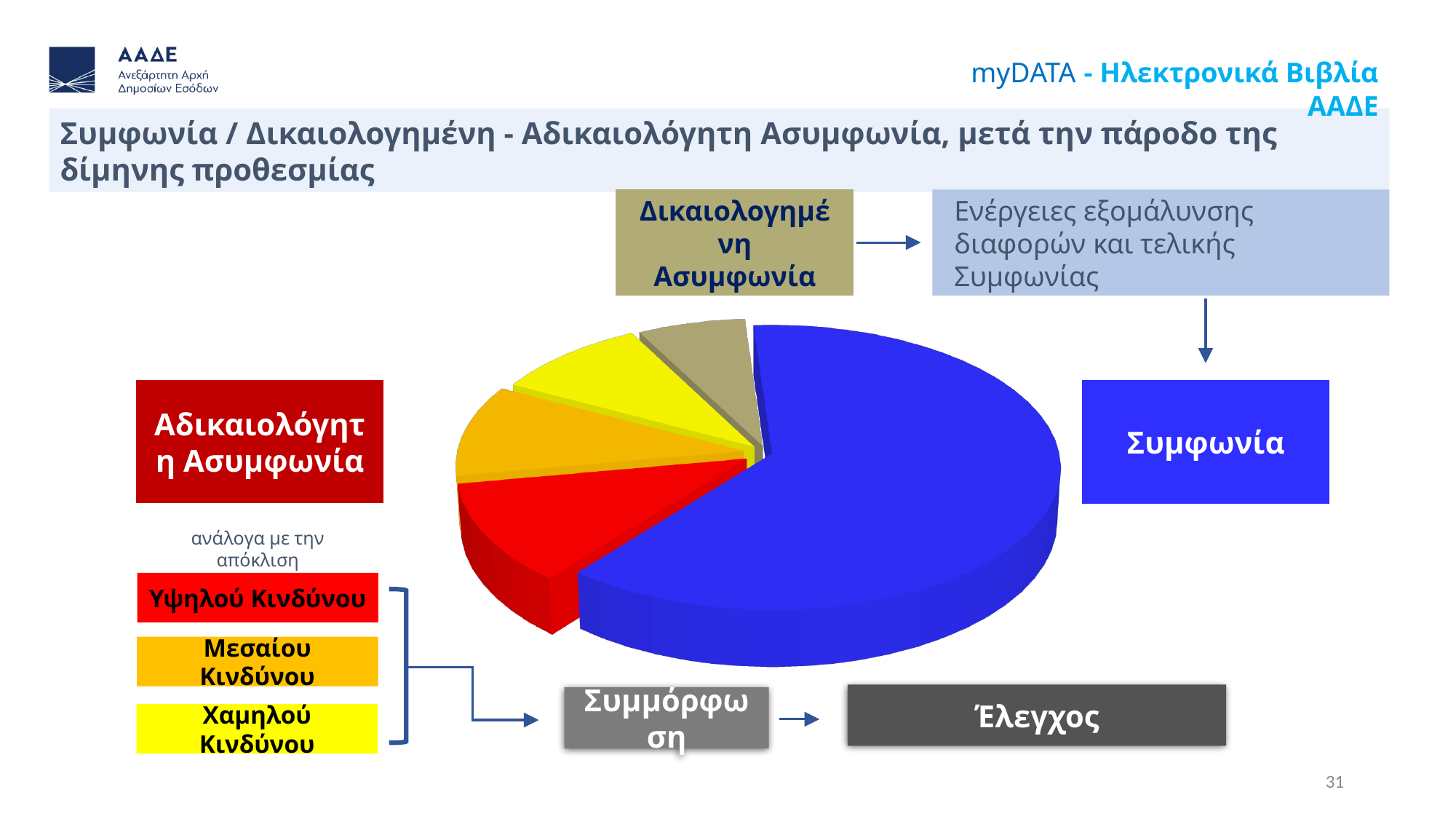
Which slice is larger, Χαμηλού Κινδύνου or Δικαιολογημένη Ασυμφωνία? Χαμηλού Κινδύνου How many slices does the pie chart have? 5 What colour is the Συμφωνία slice of the pie chart? blue Does the Συμφωνία slice take up more or less than half of the pie? more Which category has the largest slice of the pie chart? Συμφωνία Which slice is larger, Συμφωνία or Υψηλού Κινδύνου? Συμφωνία Which category has the smallest slice of the pie chart? Δικαιολογημένη Ασυμφωνία What kind of chart is shown on the slide? pie chart What colour is the Υψηλού Κινδύνου slice of the pie chart? red